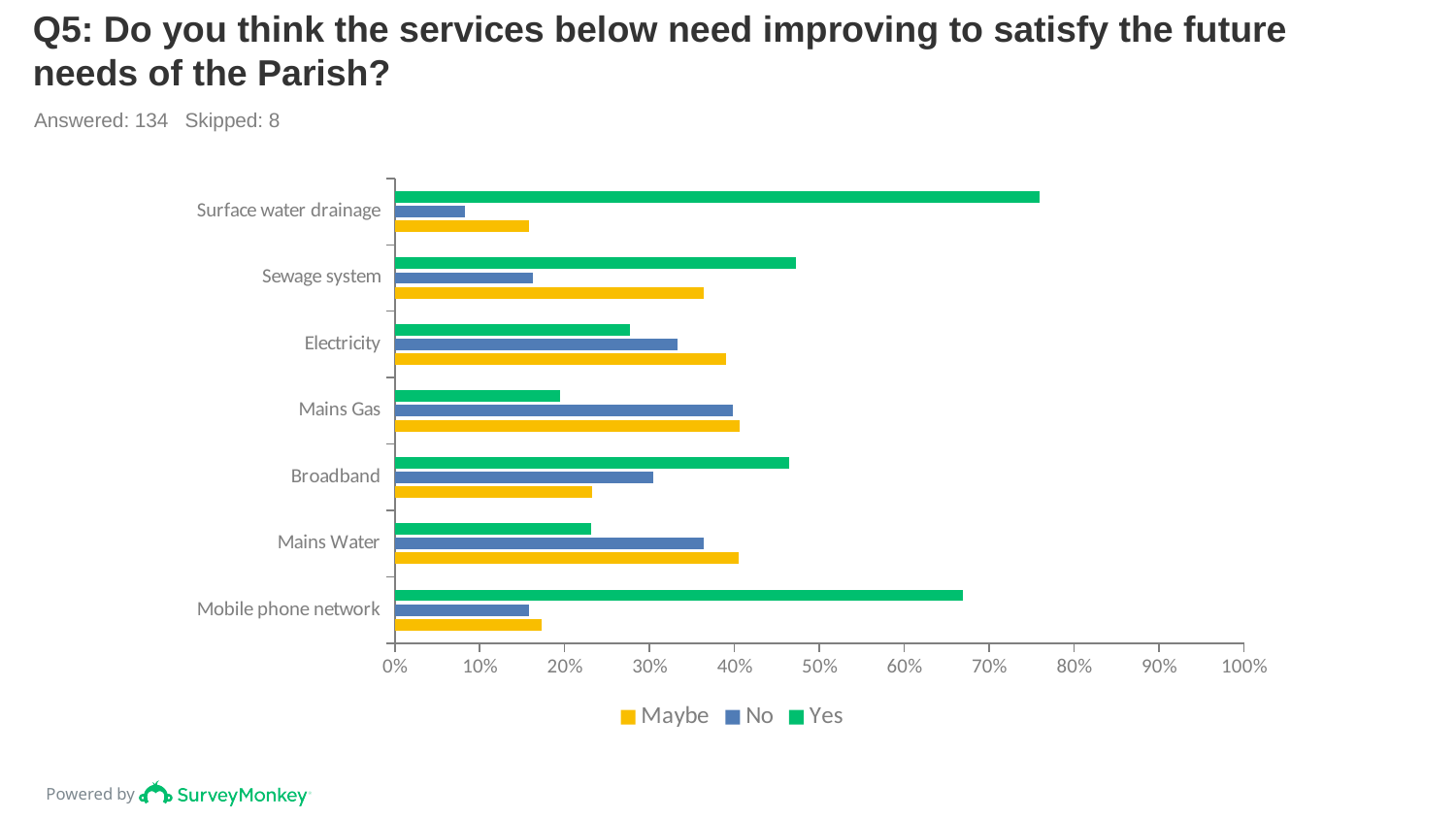
What colour represents the 'Yes' series? Green Is the 'Yes' value for Mobile phone network greater or less than 60%? greater Which service has the lowest 'No' value? Surface water drainage What kind of chart is shown on the slide? Bar chart How many services (categories) are plotted on the chart? 7 How many series does the legend list? 3 Is the 'No' value for Surface water drainage greater or less than 10%? less Which is larger: the 'Yes' value for Broadband or the 'Yes' value for Electricity? Broadband Is the 'Yes' value for Surface water drainage greater or less than 70%? greater Which service has the highest 'Yes' value? Surface water drainage What are the entries listed in the chart legend? Maybe, No, Yes Which is larger: the 'Maybe' value for Sewage system or the 'Maybe' value for Broadband? Sewage system